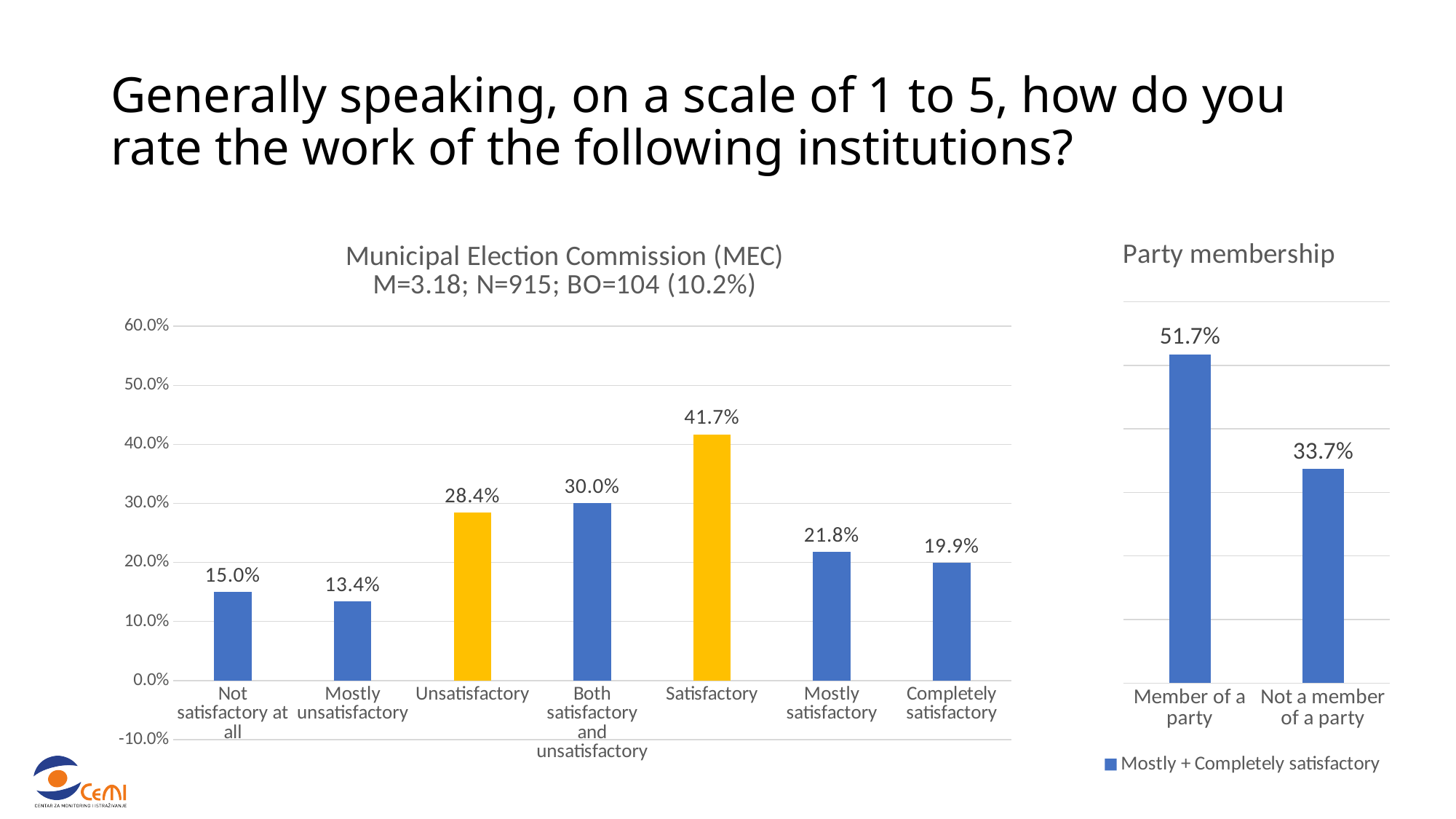
In the Party membership chart, what is the value for Member of a party? 51.7% In the Municipal Election Commission (MEC) chart, what is the difference between Both satisfactory and unsatisfactory and Unsatisfactory? 1.6% In the Party membership chart, what series does the legend list? Mostly + Completely satisfactory How many categories are shown in the Municipal Election Commission (MEC) chart? 7 What kind of chart is the Party membership chart? Bar chart In the Municipal Election Commission (MEC) chart, which category has the highest value? Satisfactory In the Municipal Election Commission (MEC) chart, which two categories have yellow bars? Unsatisfactory and Satisfactory In the Municipal Election Commission (MEC) chart, what is the value for Mostly unsatisfactory? 13.4% In the Municipal Election Commission (MEC) chart, which category has the lowest value? Mostly unsatisfactory In the Party membership chart, what is the difference between Member of a party and Not a member of a party? 18.0% In the Municipal Election Commission (MEC) chart, which is larger: Mostly satisfactory or Completely satisfactory? Mostly satisfactory In the Municipal Election Commission (MEC) chart, what is the value for Satisfactory? 41.7%